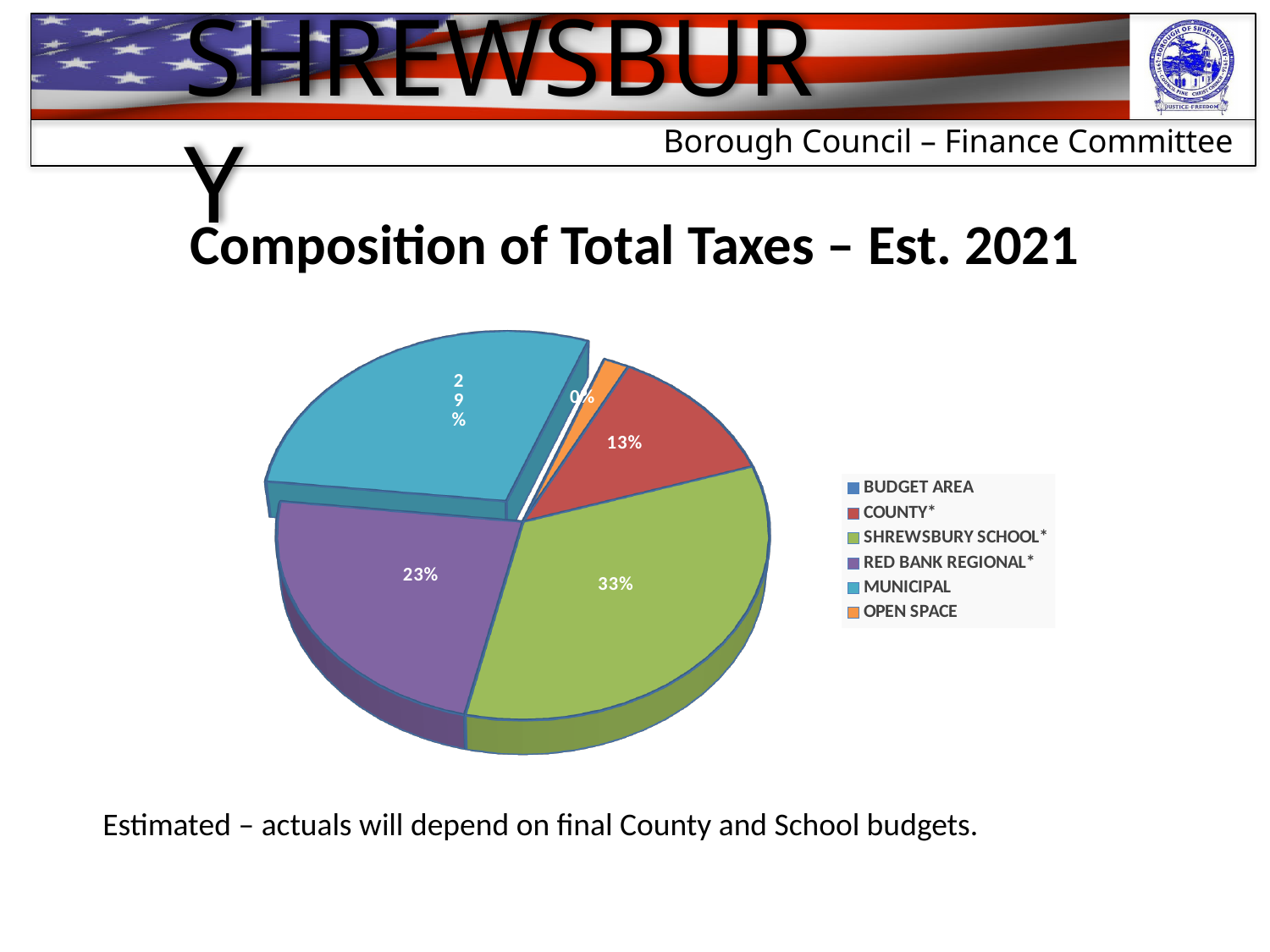
What share of total taxes does MUNICIPAL account for? 29% What is the title of the chart? Composition of Total Taxes – Est. 2021 How many percentage points larger is the SHREWSBURY SCHOOL* share than the COUNTY* share? 20 percentage points What share of total taxes does SHREWSBURY SCHOOL* account for? 33% What share of total taxes does COUNTY* account for? 13% Which is larger, the MUNICIPAL share or the RED BANK REGIONAL* share? MUNICIPAL What type of chart is shown on the slide? Pie chart How many entries does the legend list? 6 Which category has the largest share of the pie? SHREWSBURY SCHOOL* What share of total taxes does RED BANK REGIONAL* account for? 23% What colour is the SHREWSBURY SCHOOL* slice? Green